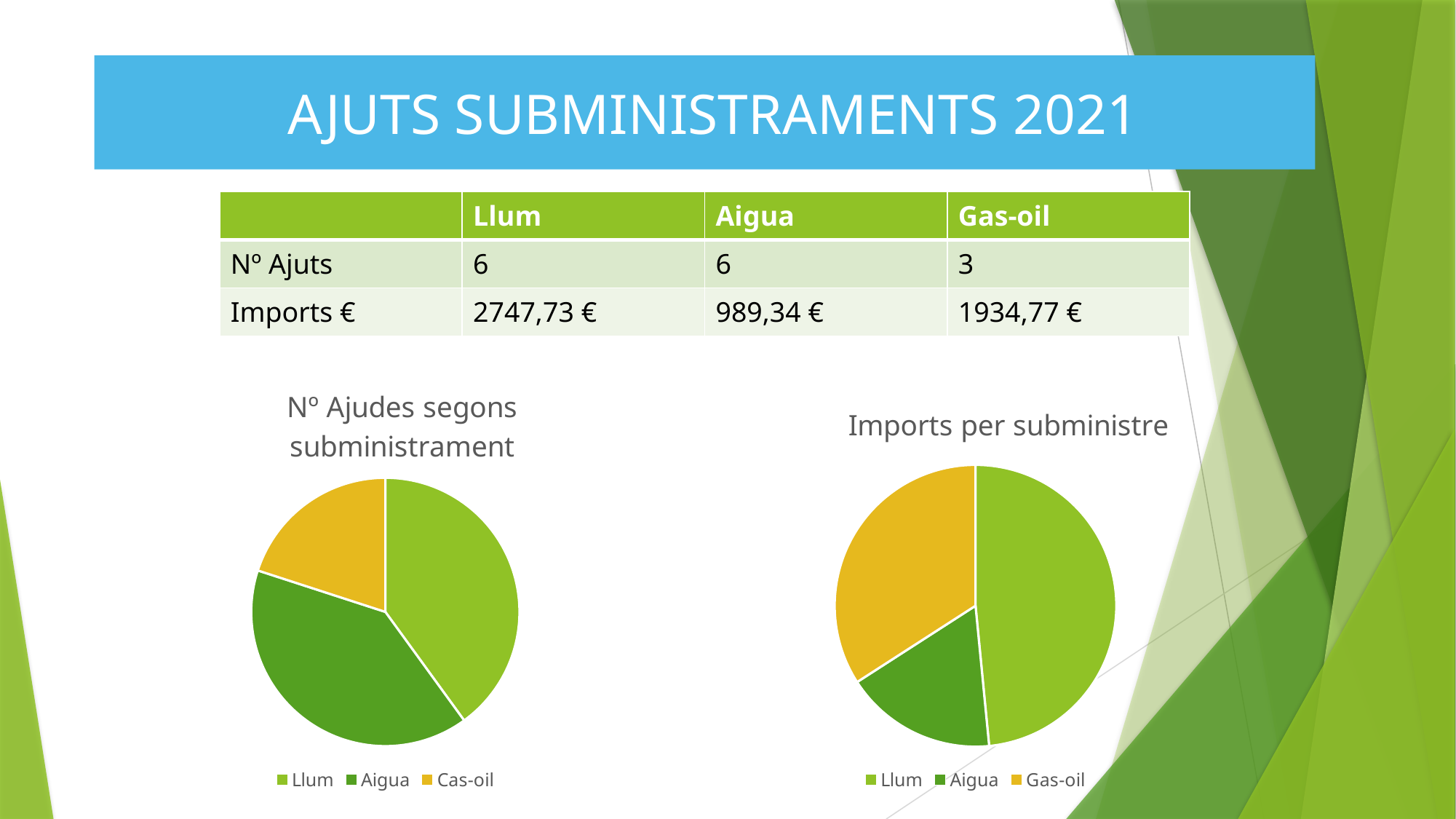
In the "Imports per subministre" chart, which category has the smallest slice? Aigua In the "Imports per subministre" chart, which category has the largest slice? Llum In the "Nº Ajudes segons subministrament" chart, what share of the pie does Llum represent? 40% How many slices does the "Imports per subministre" pie chart have? 3 In the "Imports per subministre" chart, which is larger, Gas-oil or Aigua? Gas-oil In the "Imports per subministre" chart, what is the difference between Llum and Aigua? 1758,39 € In the "Nº Ajudes segons subministrament" chart, what legend label is given to the yellow slice? Cas-oil In the "Nº Ajudes segons subministrament" chart, which category has the smallest slice? Cas-oil How many entries does the legend of the "Imports per subministre" chart list? 3 In the "Imports per subministre" chart, what is the value for Llum? 2747,73 € What kind of chart is the chart titled "Nº Ajudes segons subministrament"? pie chart